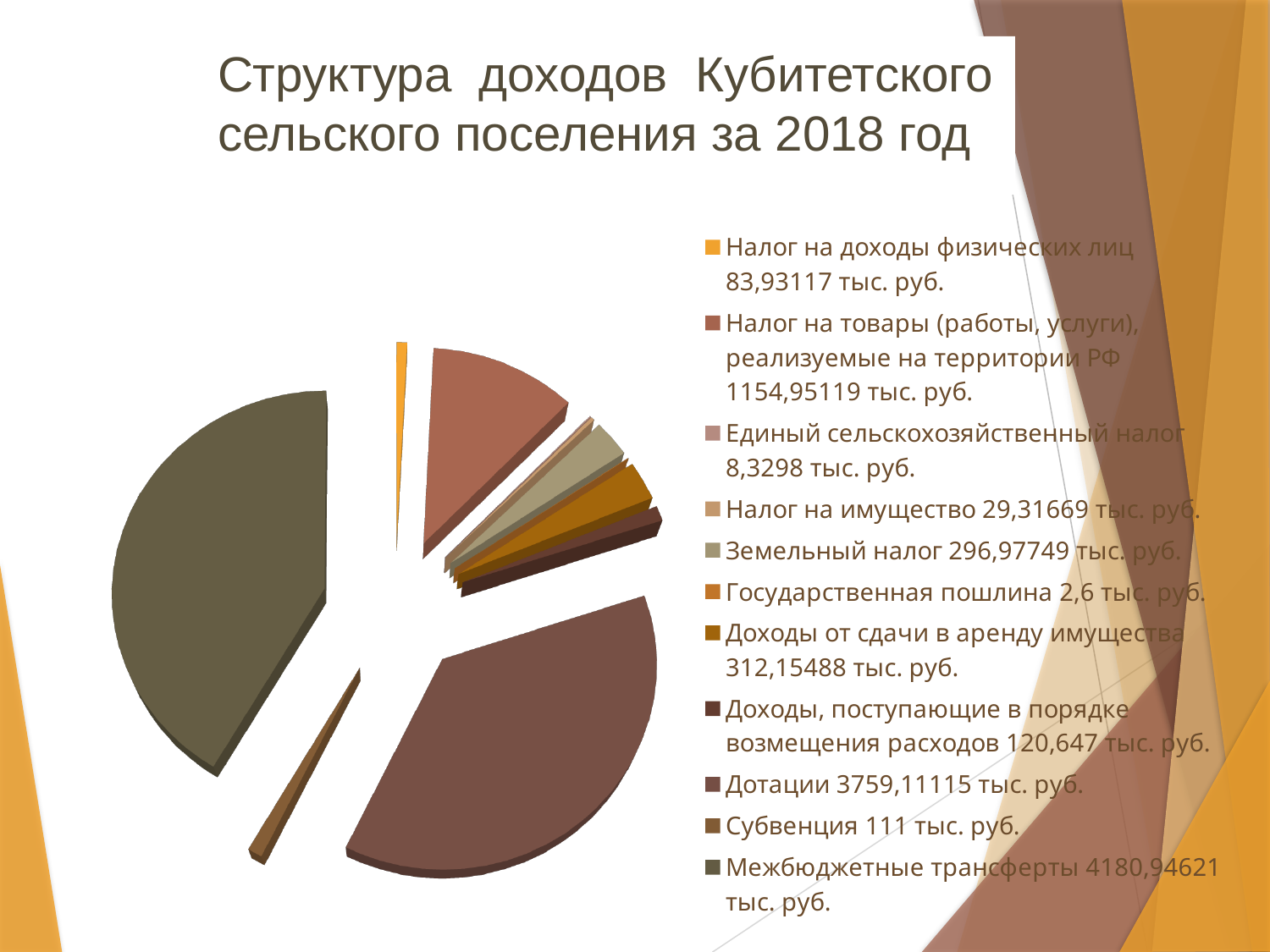
What is the difference between Межбюджетные трансферты and Дотации? 421,83506 тыс. руб. What is the value for Земельный налог? 296,97749 тыс. руб. What is the value for Дотации? 3759,11115 тыс. руб. What is the value for Субвенция? 111 тыс. руб. How many categories does the pie chart's legend list? 11 Which category has the smallest value? Государственная пошлина Which is larger: Дотации or Налог на товары (работы, услуги), реализуемые на территории РФ? Дотации What kind of chart is shown on the slide? pie chart What is the title of the chart slide? Структура доходов Кубитетского сельского поселения за 2018 год What is the value for Межбюджетные трансферты? 4180,94621 тыс. руб. What is the difference between Доходы, поступающие в порядке возмещения расходов and Субвенция? 9,647 тыс. руб. Which category has the largest value? Межбюджетные трансферты